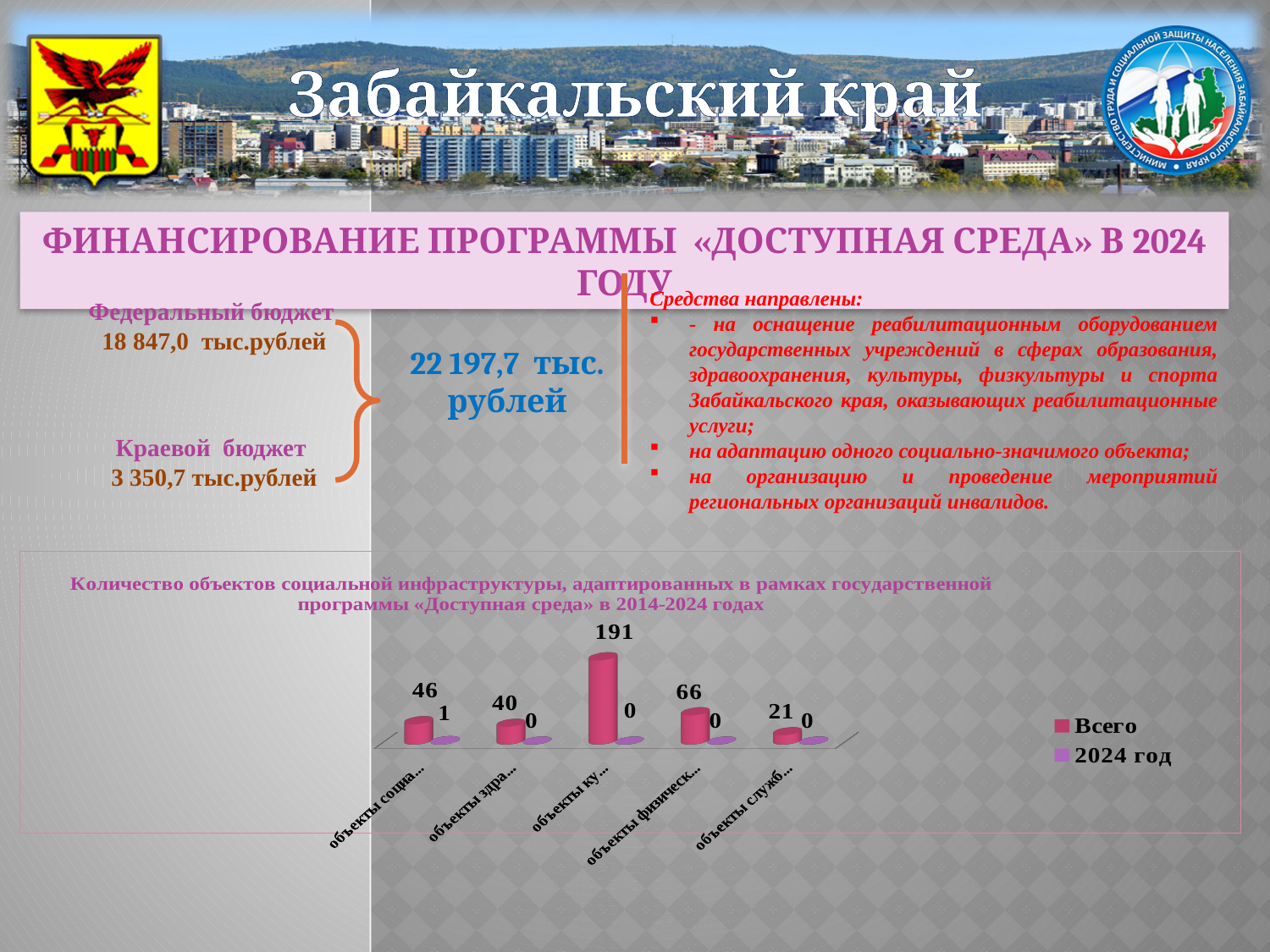
Which is larger, the 'Всего' value for 'объекты социа...' or for 'объекты здра...'? объекты социа... What is the 'Всего' value for the first category ('объекты социа...')? 46 How many series does the chart legend list? 2 What type of chart is shown on the slide? bar chart Which category has the highest 'Всего' value? объекты ку... What is the 'Всего' value for the third category ('объекты ку...')? 191 How many categories are shown on the chart's x axis? 5 Which category has the lowest 'Всего' value? объекты служб... What is the '2024 год' value for the first category ('объекты социа...')? 1 What is the 'Всего' value for the last category ('объекты служб...')? 21 What is the difference between the 'Всего' values for 'объекты физическ...' and 'объекты здра...'? 26 What are the two series named in the chart legend? Всего, 2024 год